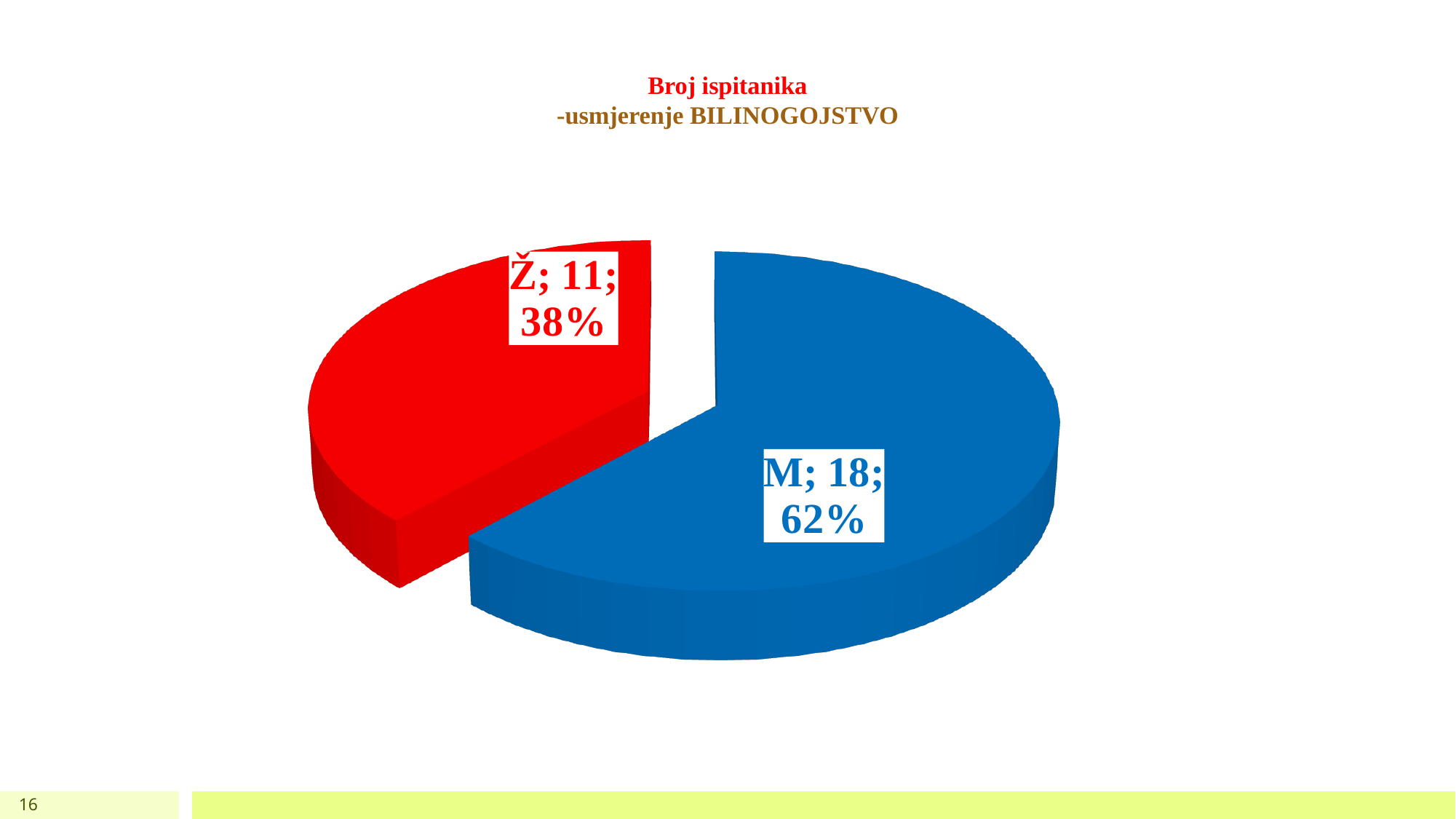
Which is larger, the value for M or the value for Ž? M What share of the pie does Ž represent? 38% What is the total of the two slice values? 29 What is the value for M? 18 What colour is the slice for Ž? red What is the difference between the values for M and Ž? 7 Which category has the smallest slice? Ž How many slices does the pie chart have? 2 What is the value for Ž? 11 What kind of chart is shown on the slide? pie chart Which category has the largest slice? M What share of the pie does M represent? 62%